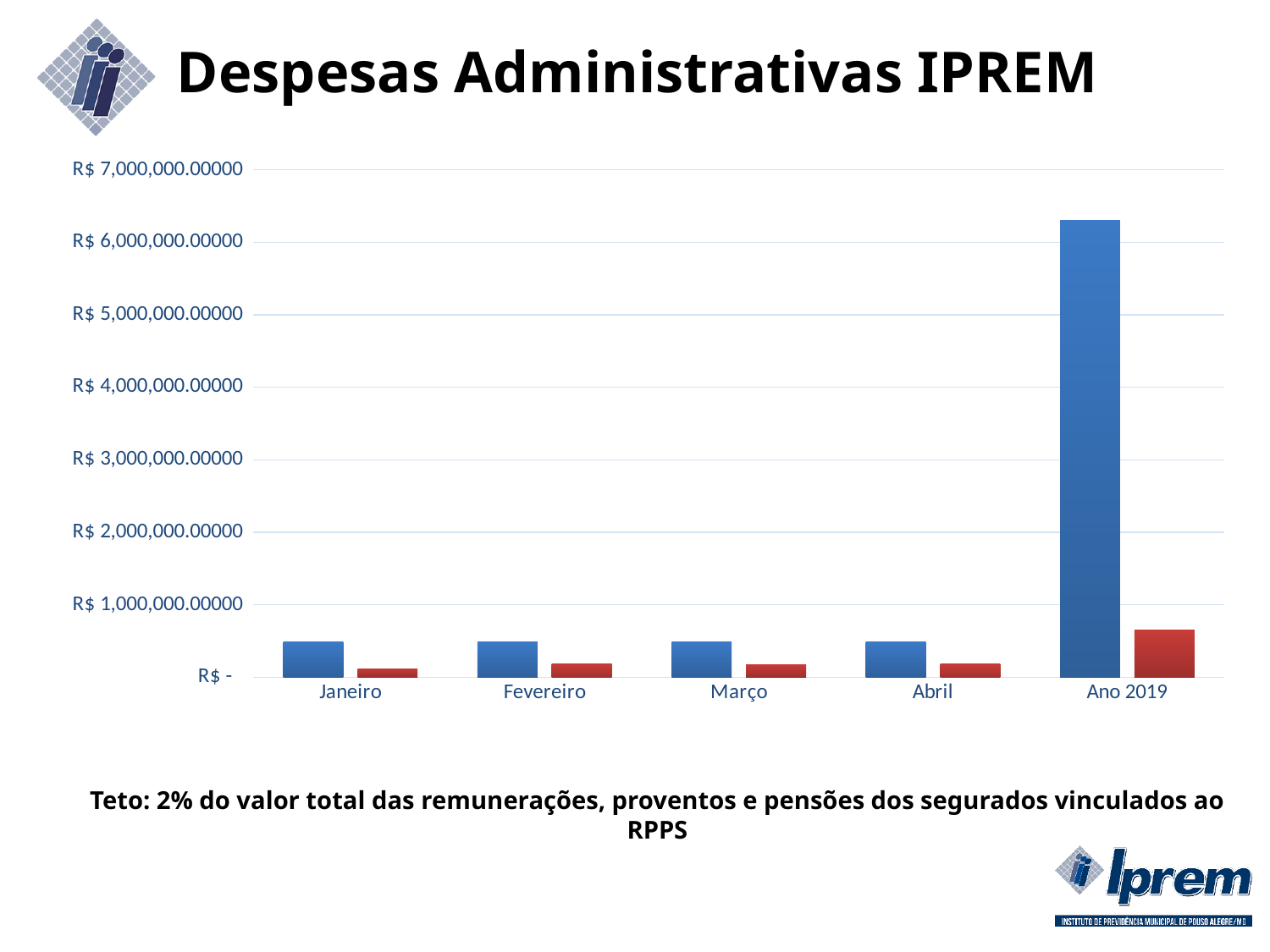
Is the value of the blue bar for Janeiro greater or less than R$ 1,000,000.00000? less Which category has the lowest red bar? Janeiro Is the value of the red bar for Ano 2019 greater or less than R$ 1,000,000.00000? less For Ano 2019, which bar is larger, the blue bar or the red bar? the blue bar For Janeiro, which bar is larger, the blue bar or the red bar? the blue bar What kind of chart is shown on the slide? bar chart What is the title of the slide containing the chart? Despesas Administrativas IPREM Which is larger, the blue bar for Abril or the blue bar for Ano 2019? Ano 2019 How many bars are shown for each category in the chart? 2 Is the value of the blue bar for Ano 2019 greater or less than R$ 6,000,000.00000? greater How many categories are shown on the x axis of the chart? 5 Which category has the tallest bar in the chart? Ano 2019